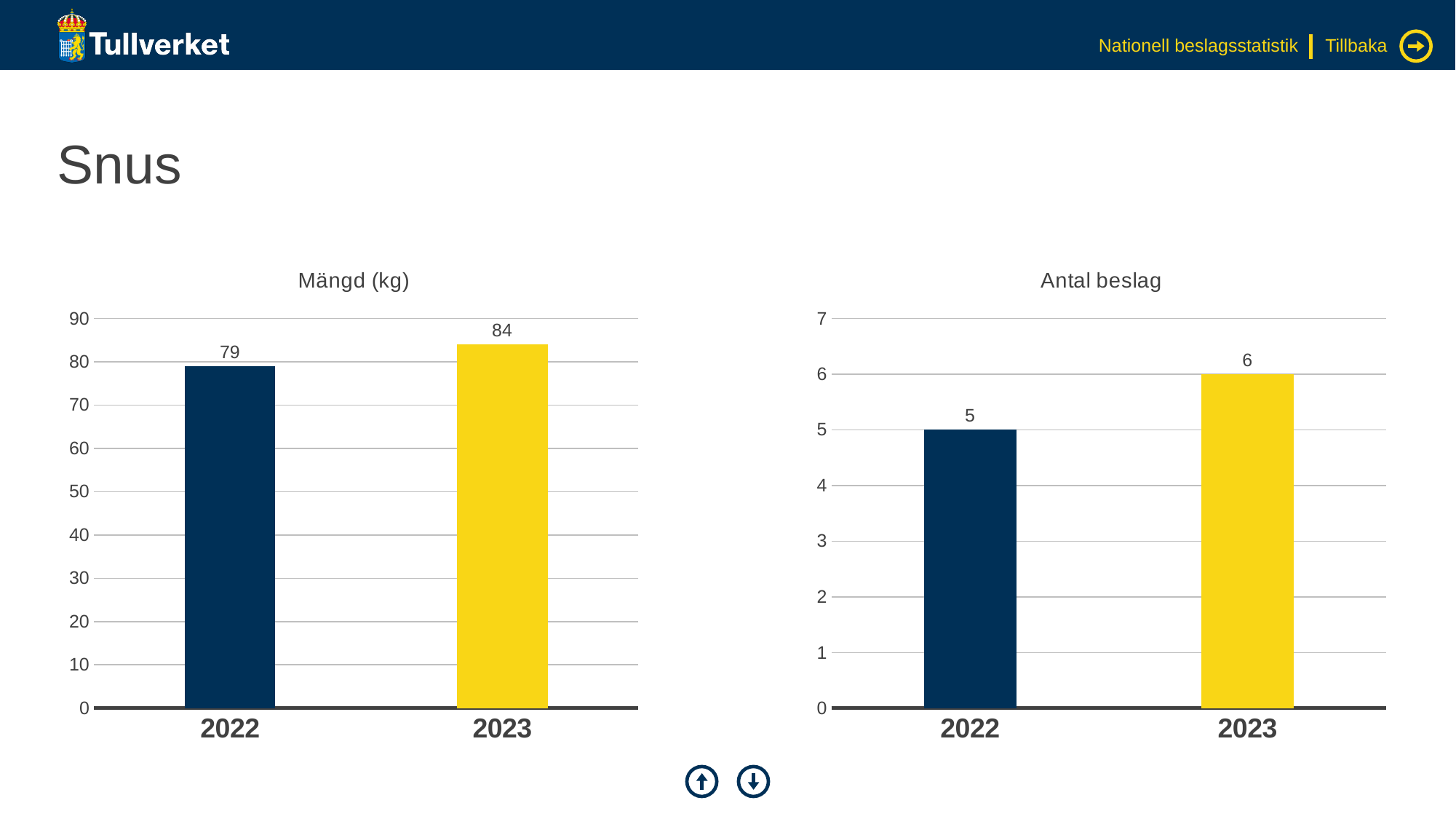
In the 'Mängd (kg)' chart, what is the difference between the 2023 and 2022 values? 5 In the 'Mängd (kg)' chart, what is the value for 2022? 79 In the 'Antal beslag' chart, what is the value for 2022? 5 How many categories are shown on the x axis of the 'Antal beslag' chart? 2 In the 'Antal beslag' chart, what is the difference between the 2023 and 2022 values? 1 In the 'Antal beslag' chart, do the values rise or fall from 2022 to 2023? rise In the 'Mängd (kg)' chart, is the value for 2022 greater or less than 80? less In the 'Mängd (kg)' chart, what is the value for 2023? 84 What kind of chart is the 'Mängd (kg)' chart? bar chart In the 'Antal beslag' chart, what is the value for 2023? 6 In the 'Antal beslag' chart, which year has the lowest value? 2022 In the 'Mängd (kg)' chart, which year has the highest value? 2023